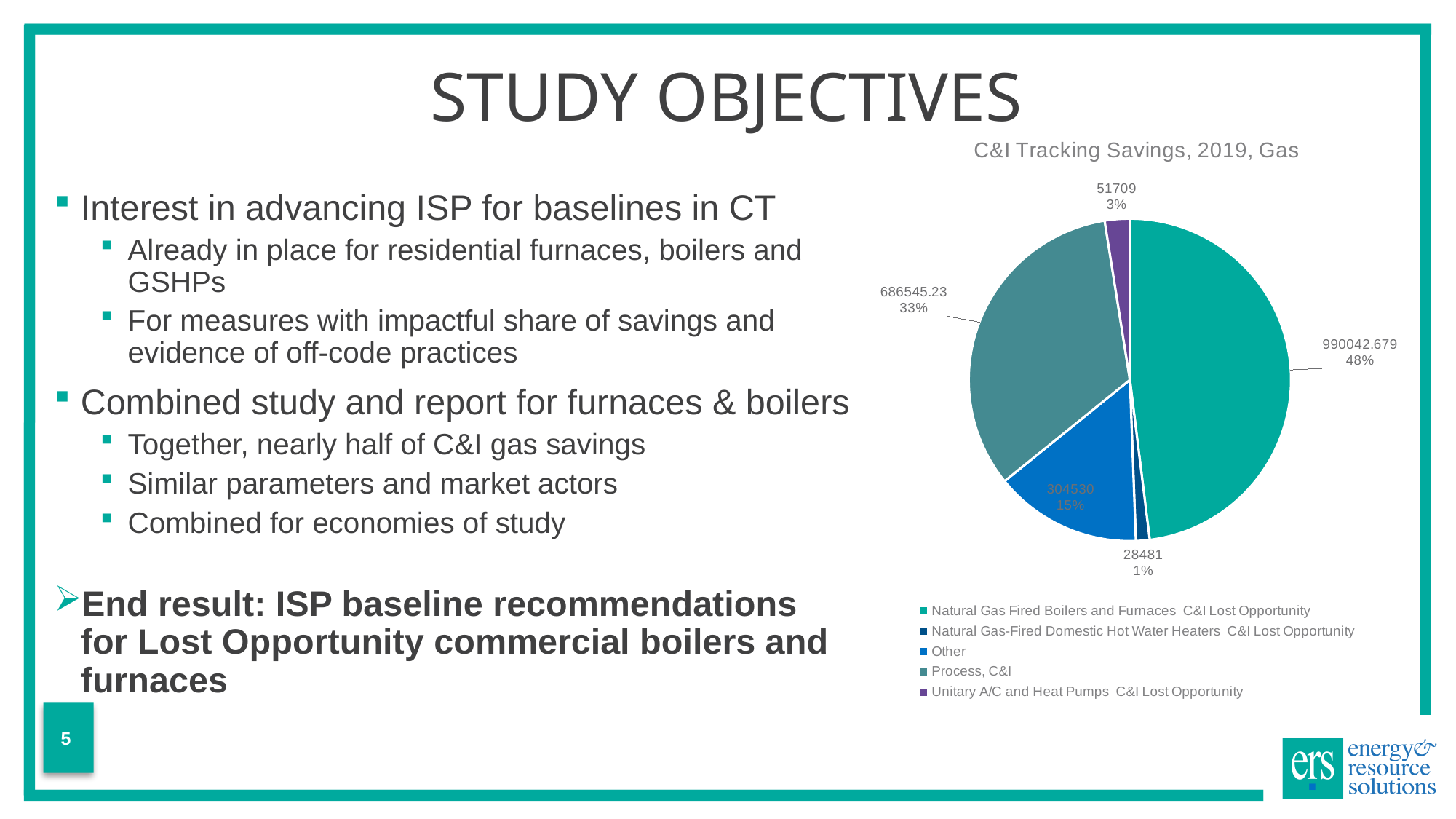
What is the title of the chart? C&I Tracking Savings, 2019, Gas Which category has the smallest slice of the pie? Natural Gas-Fired Domestic Hot Water Heaters C&I Lost Opportunity How many categories does the legend of the pie chart list? 5 What is the value for Process, C&I? 686545.23 Which is larger, the value for Other or the value for Unitary A/C and Heat Pumps C&I Lost Opportunity? Other Which category has the largest slice of the pie? Natural Gas Fired Boilers and Furnaces C&I Lost Opportunity What type of chart is shown on the slide? Pie chart What is the value for Unitary A/C and Heat Pumps C&I Lost Opportunity? 51709 What share of the pie does Natural Gas-Fired Domestic Hot Water Heaters C&I Lost Opportunity represent? 1% What share of the pie does Process, C&I represent? 33% What is the value for Other? 304530 What is the value for Natural Gas Fired Boilers and Furnaces C&I Lost Opportunity? 990042.679